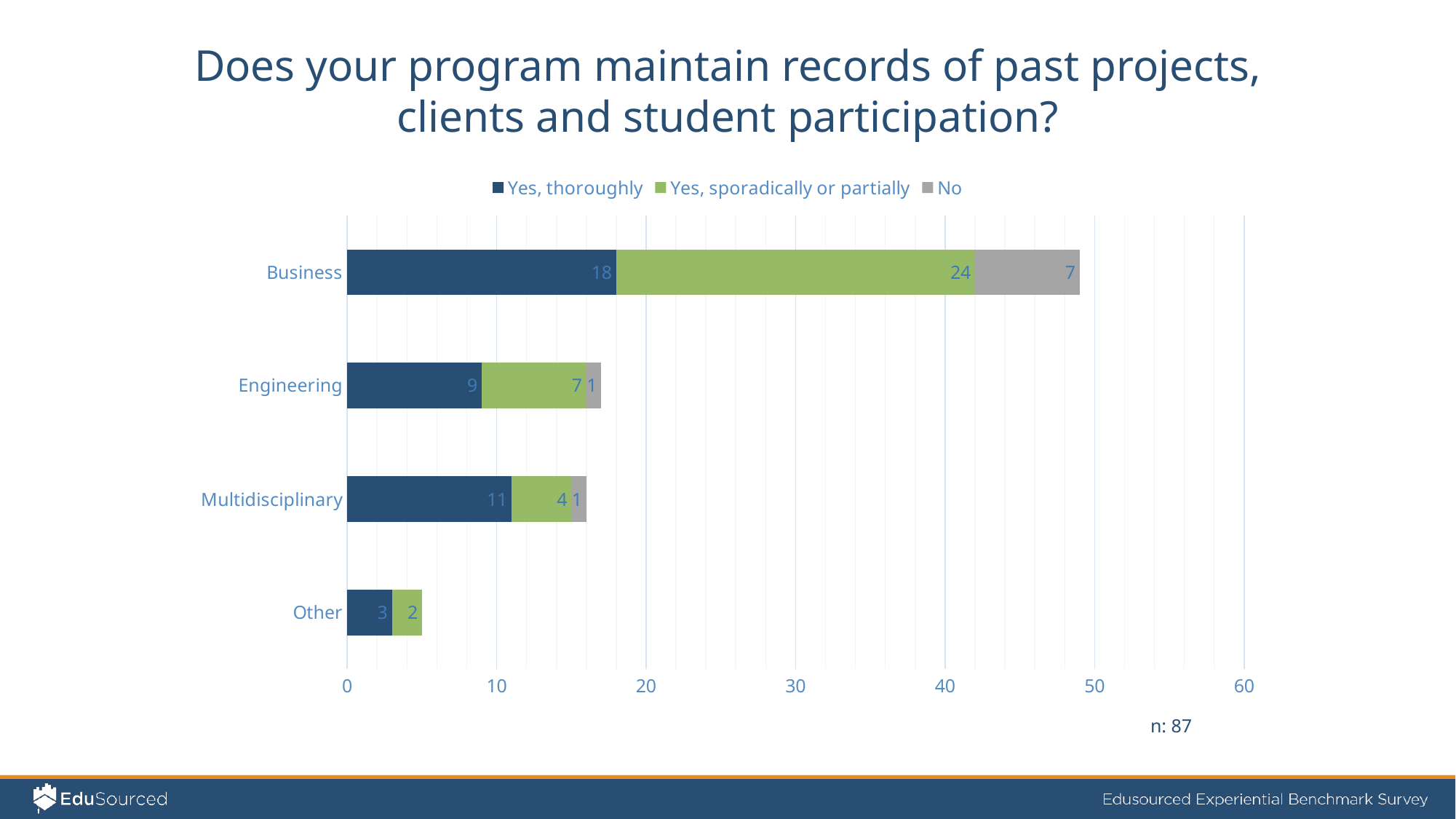
What is the value for 'No' in the Multidisciplinary category? 1 How many categories are shown on the chart? 4 What is the value for 'Yes, sporadically or partially' in the Engineering category? 7 Which is larger: the 'Yes, thoroughly' value for Engineering or for Multidisciplinary? Multidisciplinary What kind of chart is shown on the slide? Stacked bar chart Which category has the lowest value for 'Yes, thoroughly'? Other What is the difference between the 'Yes, sporadically or partially' and 'Yes, thoroughly' values for Business? 6 What is the total of the stacked bar for Engineering? 17 How many series does the legend list? 3 Which category has the highest value for 'Yes, sporadically or partially'? Business What is the value for 'Yes, thoroughly' in the Business category? 18 What is the total of the stacked bar for Business? 49